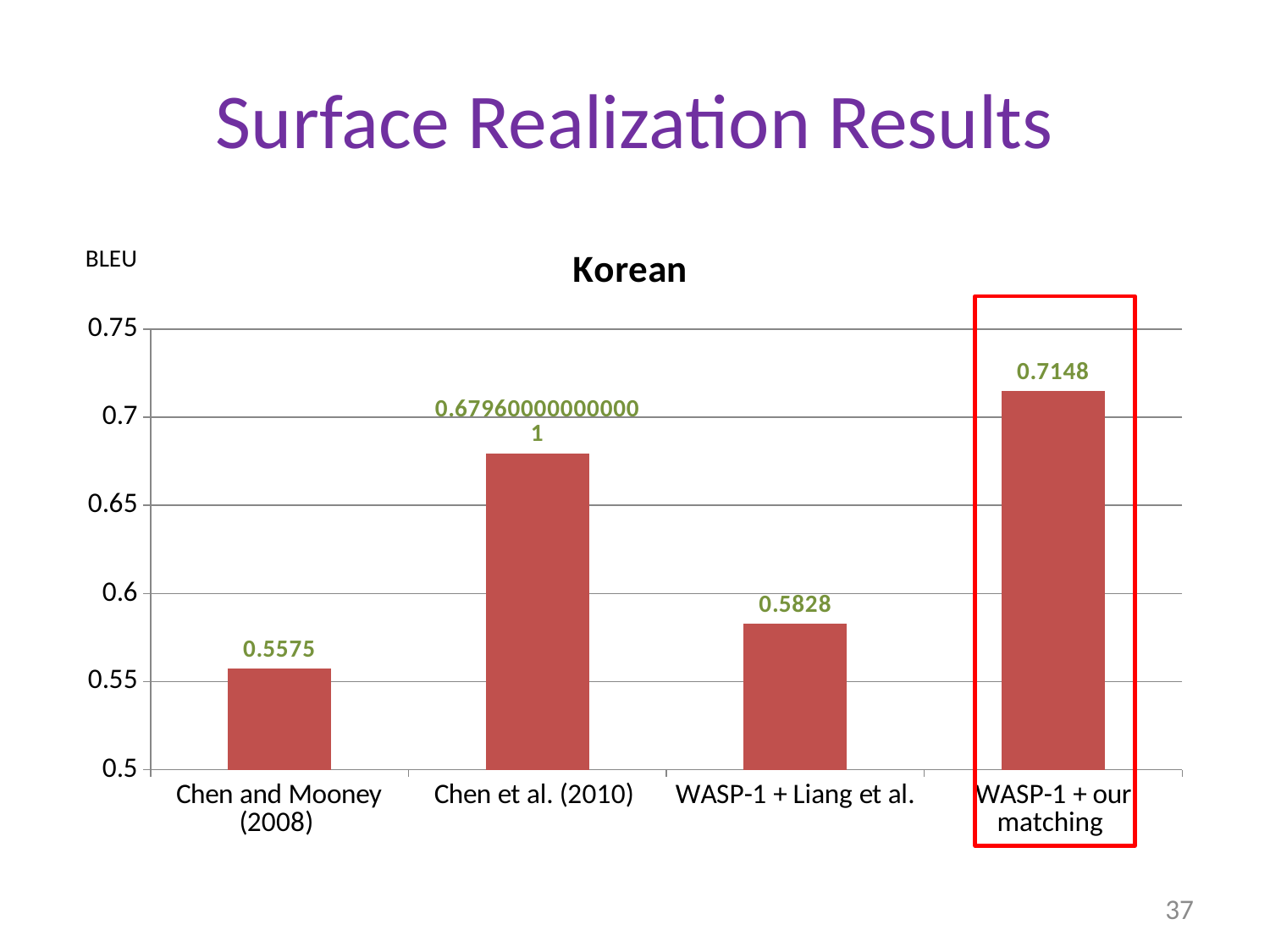
What is the BLEU score for WASP-1 + our matching? 0.7148 What is the difference in BLEU score between WASP-1 + our matching and Chen and Mooney (2008)? 0.1573 What is the BLEU score for Chen and Mooney (2008)? 0.5575 What is the difference in BLEU score between WASP-1 + our matching and WASP-1 + Liang et al.? 0.1320 What kind of chart is shown on the slide? bar chart Is the BLEU score for Chen et al. (2010) greater or less than 0.65? greater Which system has the lowest BLEU score? Chen and Mooney (2008) What is the BLEU score for WASP-1 + Liang et al.? 0.5828 What is the title of the chart? Korean How many systems are compared in the chart? 4 Which has a higher BLEU score, Chen et al. (2010) or WASP-1 + Liang et al.? Chen et al. (2010) Which system has the highest BLEU score? WASP-1 + our matching